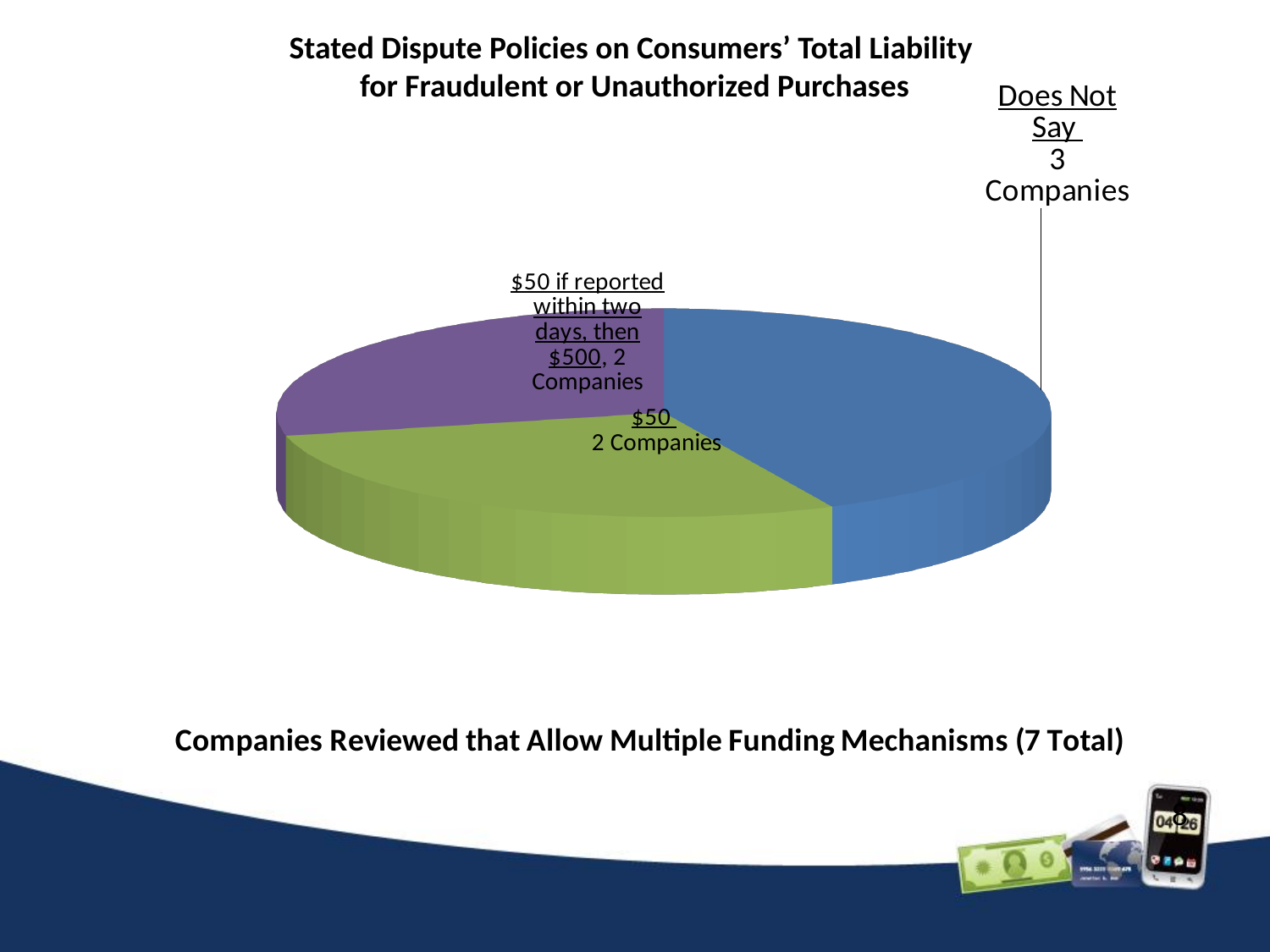
What share of the 7 companies reviewed fall under "Does Not Say"? 3 of 7 Which has more companies: "Does Not Say" or "$50"? Does Not Say How many companies have the policy "$50 if reported within two days, then $500"? 2 Companies What colour is the "Does Not Say" slice of the pie? blue How many companies fall under the "Does Not Say" category? 3 Companies What kind of chart is shown on the slide? pie chart How many companies in total are represented in the chart? 7 Which category has the largest number of companies? Does Not Say How many more companies are in "Does Not Say" than in "$50"? 1 What is the title of the chart? Companies Reviewed that Allow Multiple Funding Mechanisms (7 Total) How many companies have a stated liability policy of "$50"? 2 Companies How many categories (slices) does the pie chart have? 3